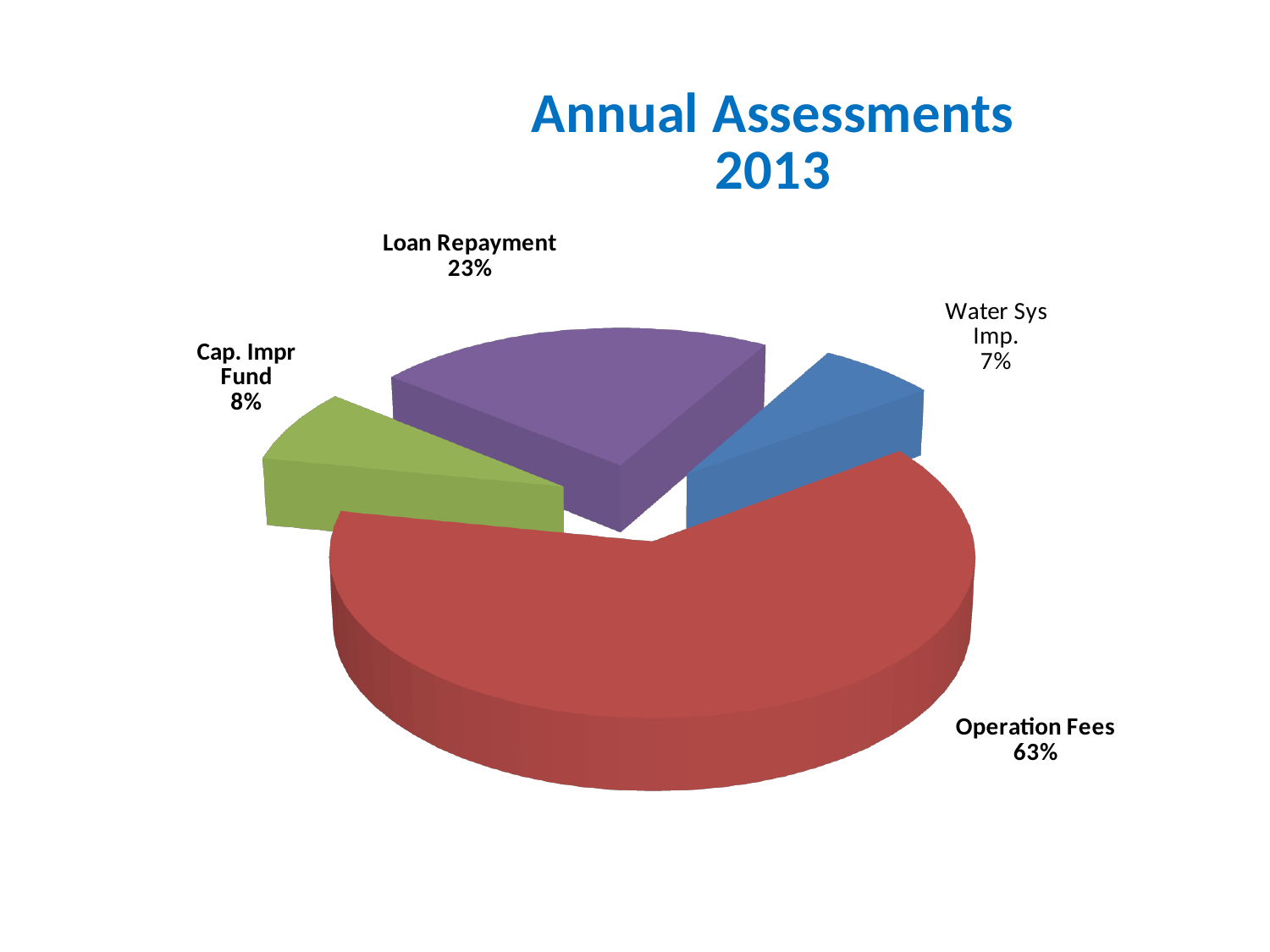
Which category has the largest slice of the pie? Operation Fees What share of the pie does Operation Fees represent? 63% What colour is the Operation Fees slice? Red Which category has the smallest slice of the pie? Water Sys Imp. How many categories are shown in the pie chart? 4 What is the difference in percentage points between Operation Fees and Loan Repayment? 40 What percentage is shown for Loan Repayment? 23% What is the title of the chart? Annual Assessments 2013 What percentage is shown for Cap. Impr Fund? 8% What percentage is shown for Water Sys Imp.? 7% Which is larger, Loan Repayment or Cap. Impr Fund? Loan Repayment What kind of chart is shown on the slide? Pie chart